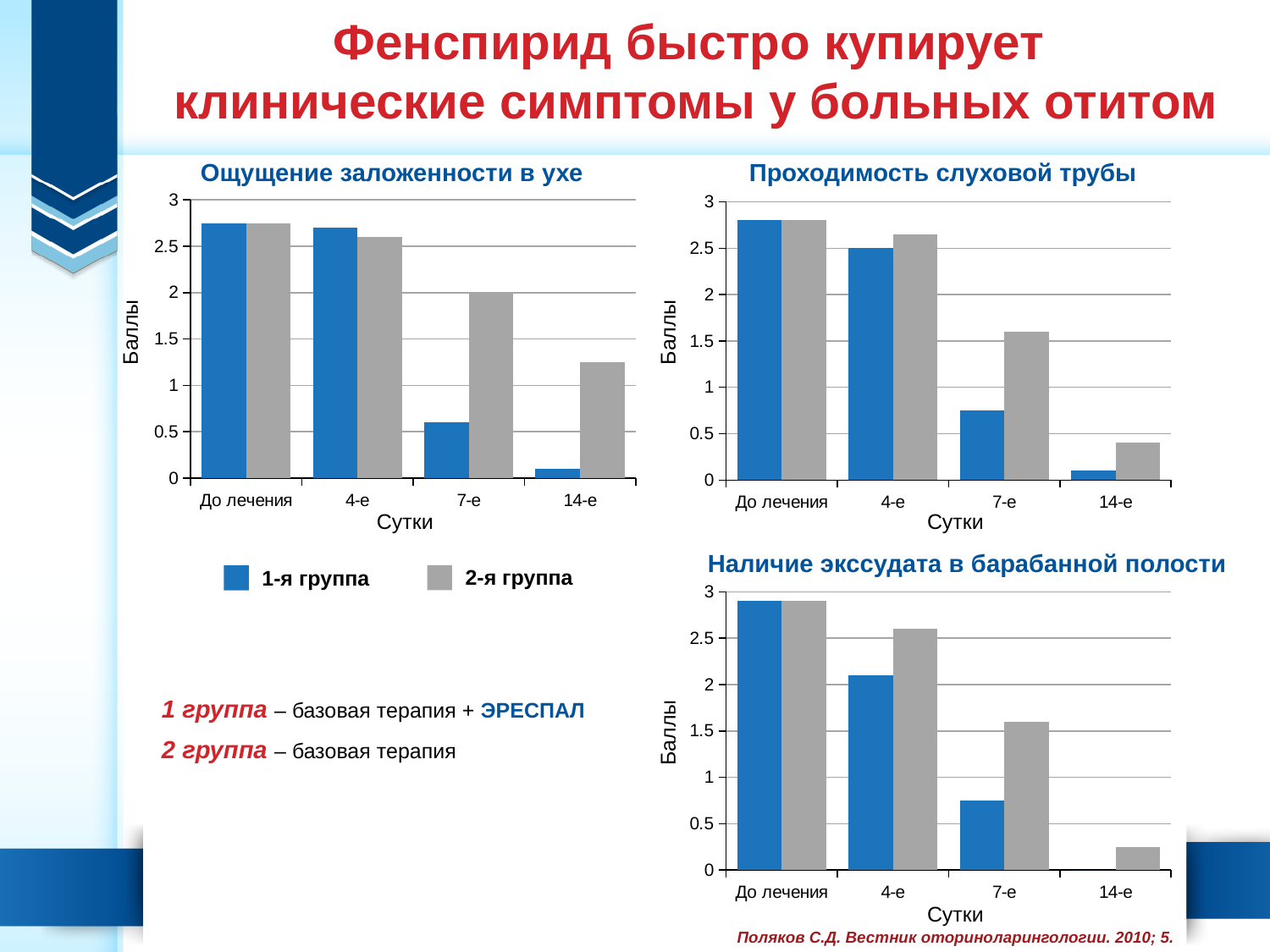
In the "Ощущение заложенности в ухе" chart, what is the value for 2-я группа at 7-е? 2 In the "Проходимость слуховой трубы" chart, at which category is the value for 1-я группа lowest? 14-е How many categories are shown on the x axis of the "Проходимость слуховой трубы" chart? 4 In the "Проходимость слуховой трубы" chart, do the values for 1-я группа rise or fall along the x axis? fall What kind of chart is "Ощущение заложенности в ухе"? bar chart In the "Наличие экссудата в барабанной полости" chart, is the value for 1-я группа at 7-е greater or less than 1? less In the "Ощущение заложенности в ухе" chart, is the value for 2-я группа at 14-е greater or less than 1? greater In the "Ощущение заложенности в ухе" chart, which group has the higher value at 14-е? 2-я группа In the "Проходимость слуховой трубы" chart, is the value for 2-я группа at 7-е greater or less than 1? greater What is the y-axis label on the "Наличие экссудата в барабанной полости" chart? Баллы How many series does the legend list for the charts? 2